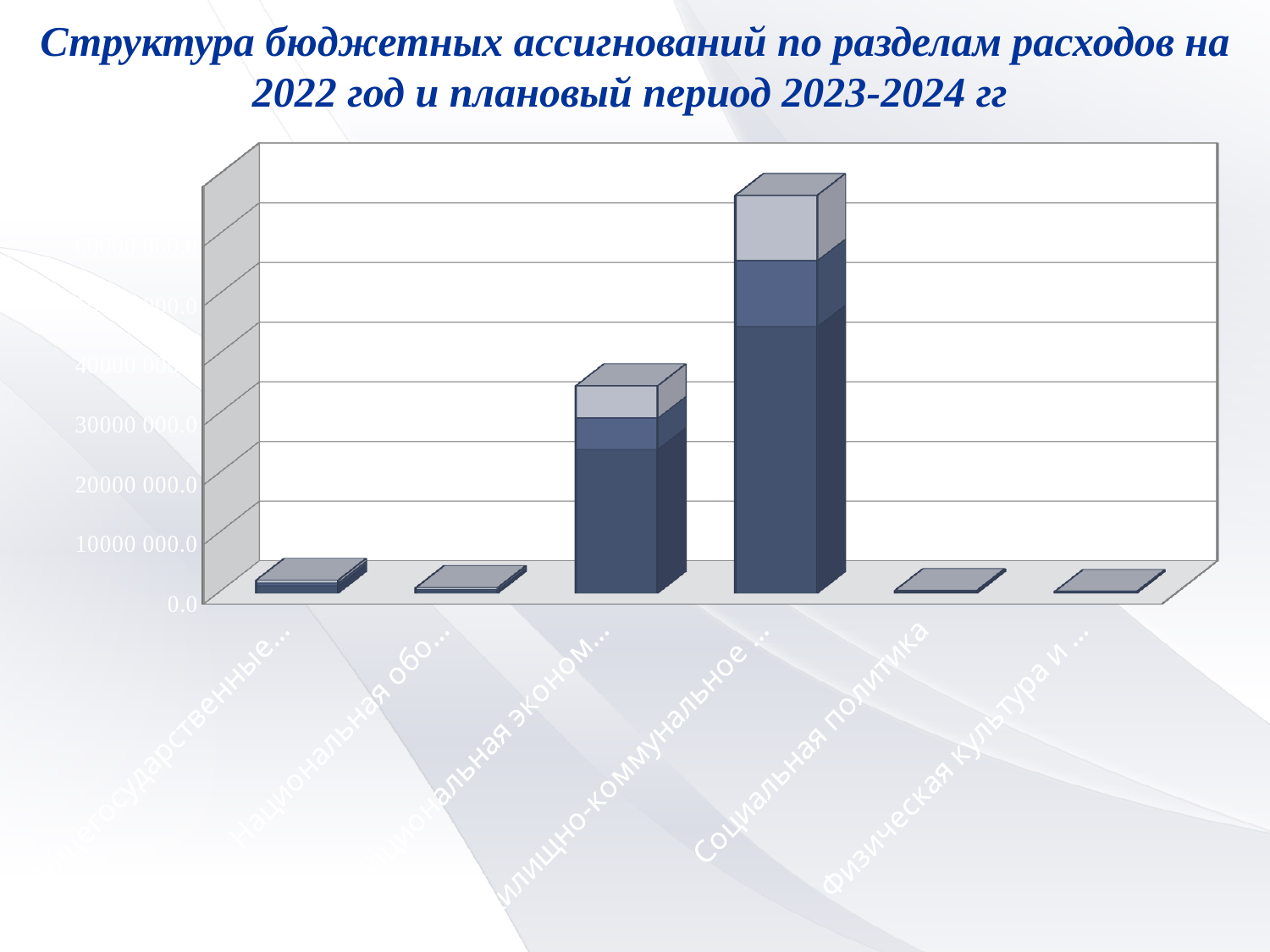
Is the value for the category beginning 'Общегосударственные' greater or less than 10000 000.0? less Is the value for Социальная политика greater or less than 10000 000.0? less Which bar is taller: Социальная политика or the category beginning 'Национальная эконом'? Национальная эконом... What is the title of the slide containing the chart? Структура бюджетных ассигнований по разделам расходов на 2022 год и плановый период 2023-2024 гг Is the total value of the bar for the category beginning 'Жилищно-коммунальное' greater or less than 50000 000.0? greater Do the bar values rise steadily from left to right along the x axis? No Which category has the tallest bar in the chart? Жилищно-коммунальное ... Which bar is taller: the one for the category beginning 'Национальная эконом' or the one for the category beginning 'Жилищно-коммунальное'? Жилищно-коммунальное ... How many categories are plotted along the x axis of the chart? 6 How many stacked segments are visible in the tallest bar of the chart? 3 What kind of chart is shown on the slide? Stacked bar chart